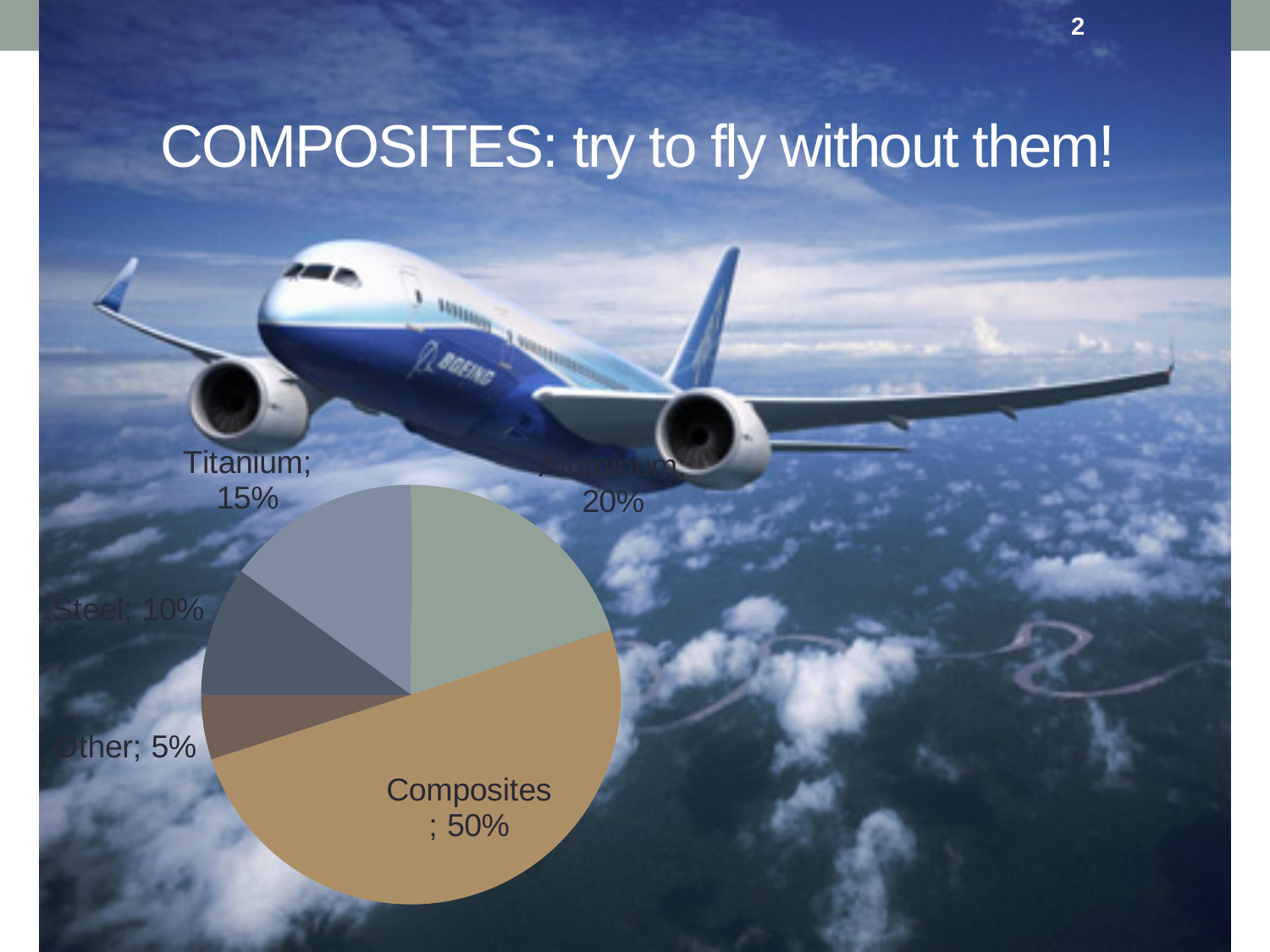
What is the difference in percentage points between Composites and Aluminum? 30 What is the combined share of Titanium and Steel? 25% Which is larger, the Titanium slice or the Steel slice? Titanium Which material has the largest slice of the pie chart? Composites What share of the pie chart is Titanium? 15% What share of the pie chart is Aluminum? 20% What share of the pie chart is Other? 5% What kind of chart is shown on the slide? Pie chart What share of the pie chart is Composites? 50% How many slices does the pie chart have? 5 What share of the pie chart is Steel? 10% Which material has the smallest slice of the pie chart? Other